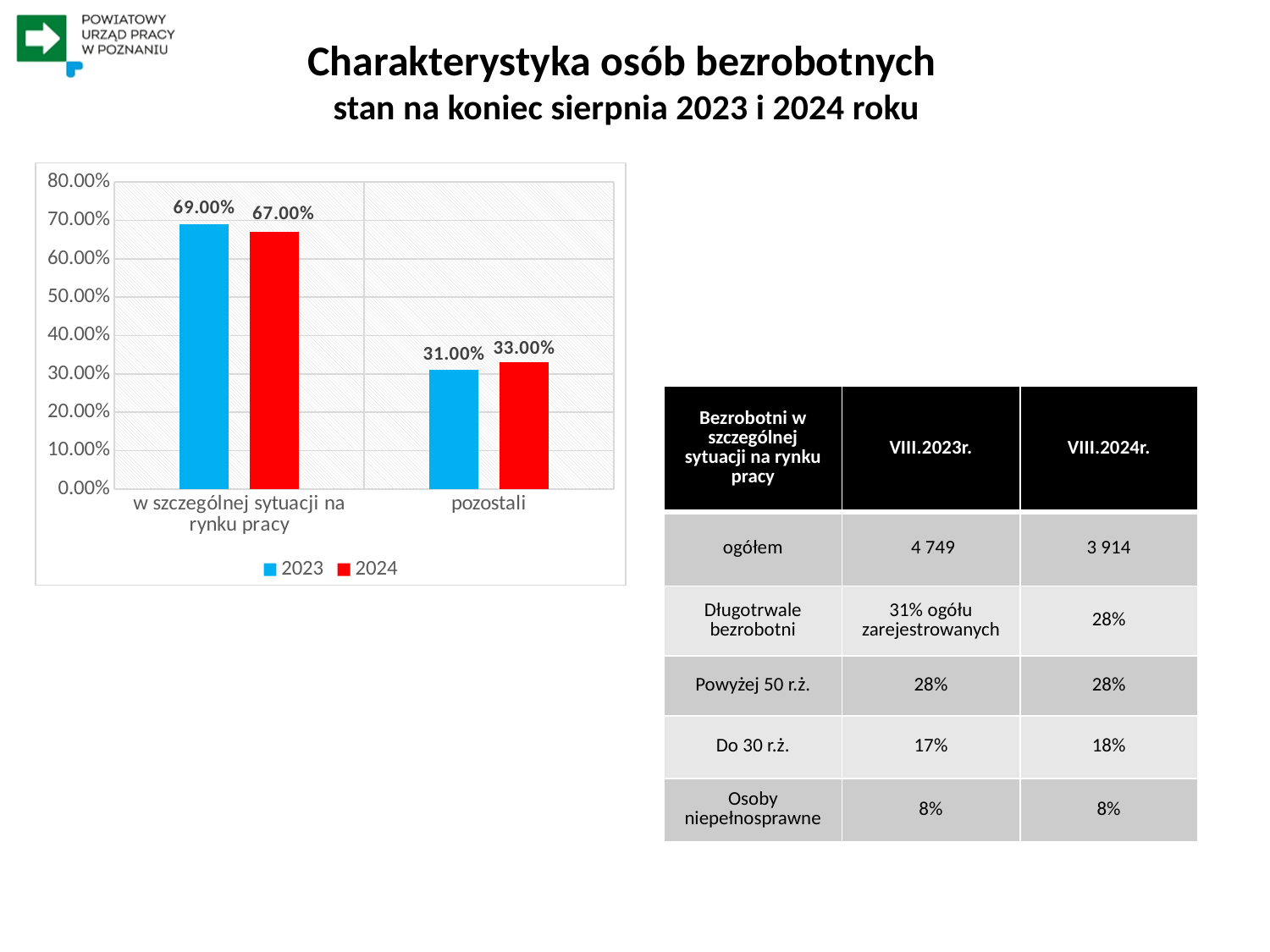
Which category has the highest value in the 2023 series? w szczególnej sytuacji na rynku pracy What colour represents the 2024 series in the chart? red Which category has the lowest value in the 2024 series? pozostali What kind of chart is shown on the slide? bar chart How many series does the chart legend list? 2 What is the difference between the 2023 and 2024 values for 'pozostali'? 2.00% What is the value for 'pozostali' in the 2024 series? 33.00% What is the value for 'w szczególnej sytuacji na rynku pracy' in the 2024 series? 67.00% What is the value for 'pozostali' in the 2023 series? 31.00% What is the value for 'w szczególnej sytuacji na rynku pracy' in the 2023 series? 69.00% Which is larger for 'w szczególnej sytuacji na rynku pracy': the 2023 value or the 2024 value? 2023 How many categories are shown on the x axis of the chart? 2